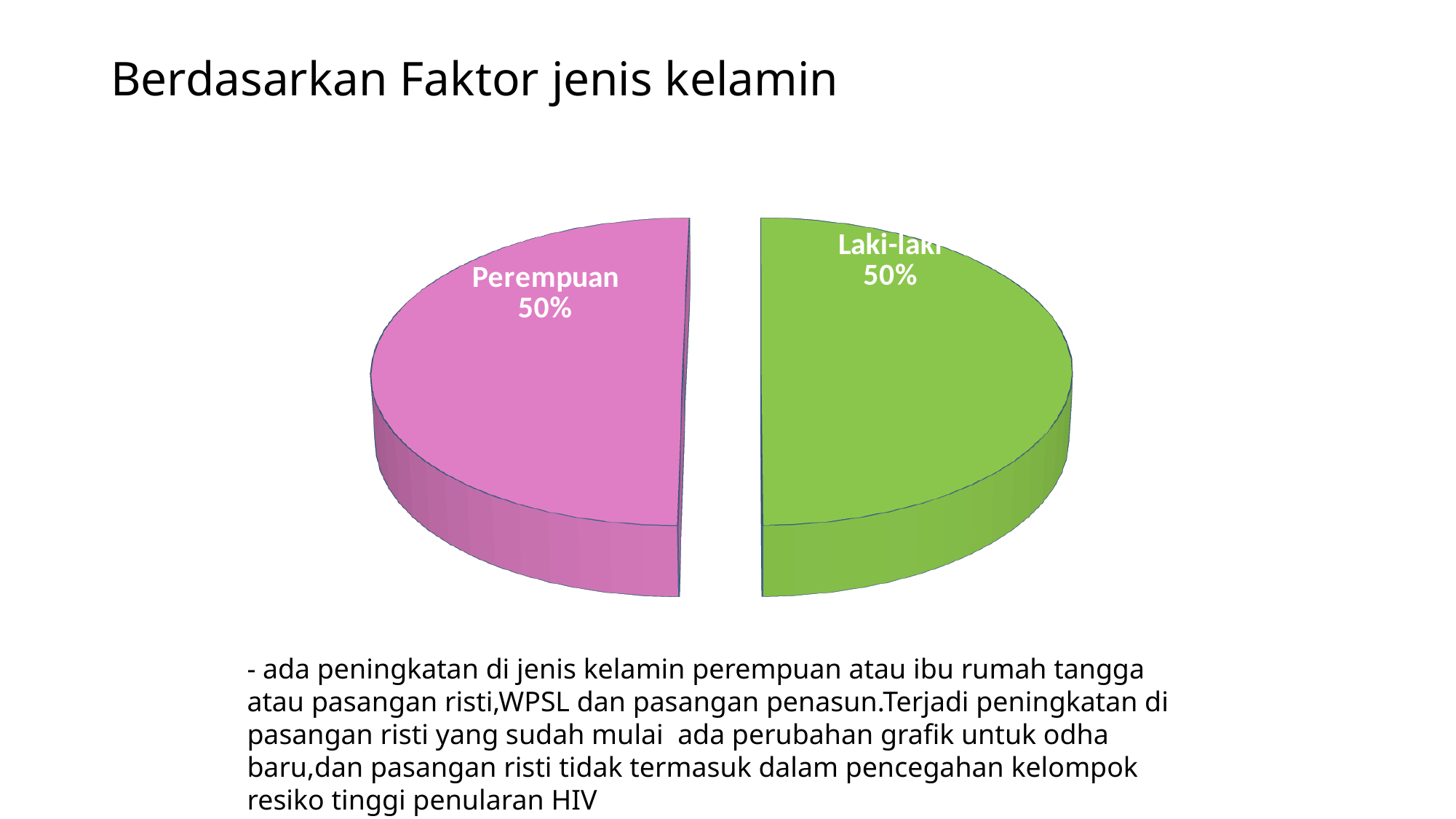
What share of the pie does Perempuan represent? 50% What colour is the Laki-laki slice? green What share of the pie does Laki-laki represent? 50% What kind of chart is shown on the slide? pie chart What is the combined share of Perempuan and Laki-laki? 100% Is the share for Perempuan greater or less than 60%? less Is the share for Laki-laki greater or less than 40%? greater How many slices does the pie chart have? 2 What colour is the Perempuan slice? pink What is the difference between the Perempuan and Laki-laki shares? 0%